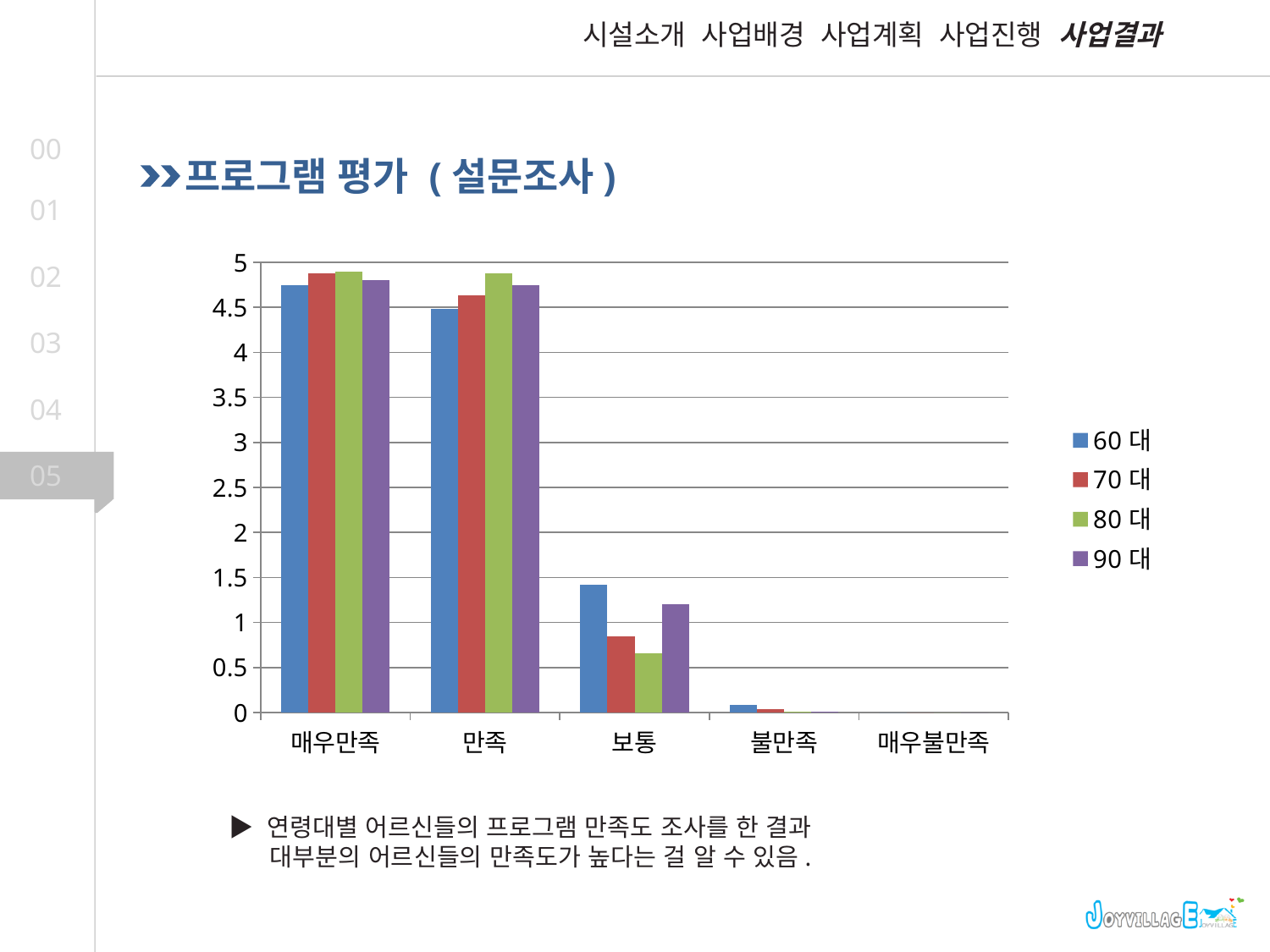
Is the value for 80 대 in the 보통 category greater or less than 1? less Is the value for 60 대 in the 보통 category greater or less than 1? greater What kind of chart is shown on the slide? bar chart What is the title of the slide section containing the chart? 프로그램 평가 ( 설문조사 ) How many series does the chart's legend list? 4 Is the value for 70 대 in the 매우만족 category greater or less than 4.5? greater Which series has the highest value in the 보통 category? 60 대 Which series are listed in the chart's legend? 60 대, 70 대, 80 대, 90 대 In the 만족 category, which is larger: the value for 60 대 or for 80 대? 80 대 How many categories are shown on the x axis of the chart? 5 Do the values generally rise or fall moving from 매우만족 to 매우불만족 along the x axis? fall Which series has the lowest value in the 보통 category? 80 대